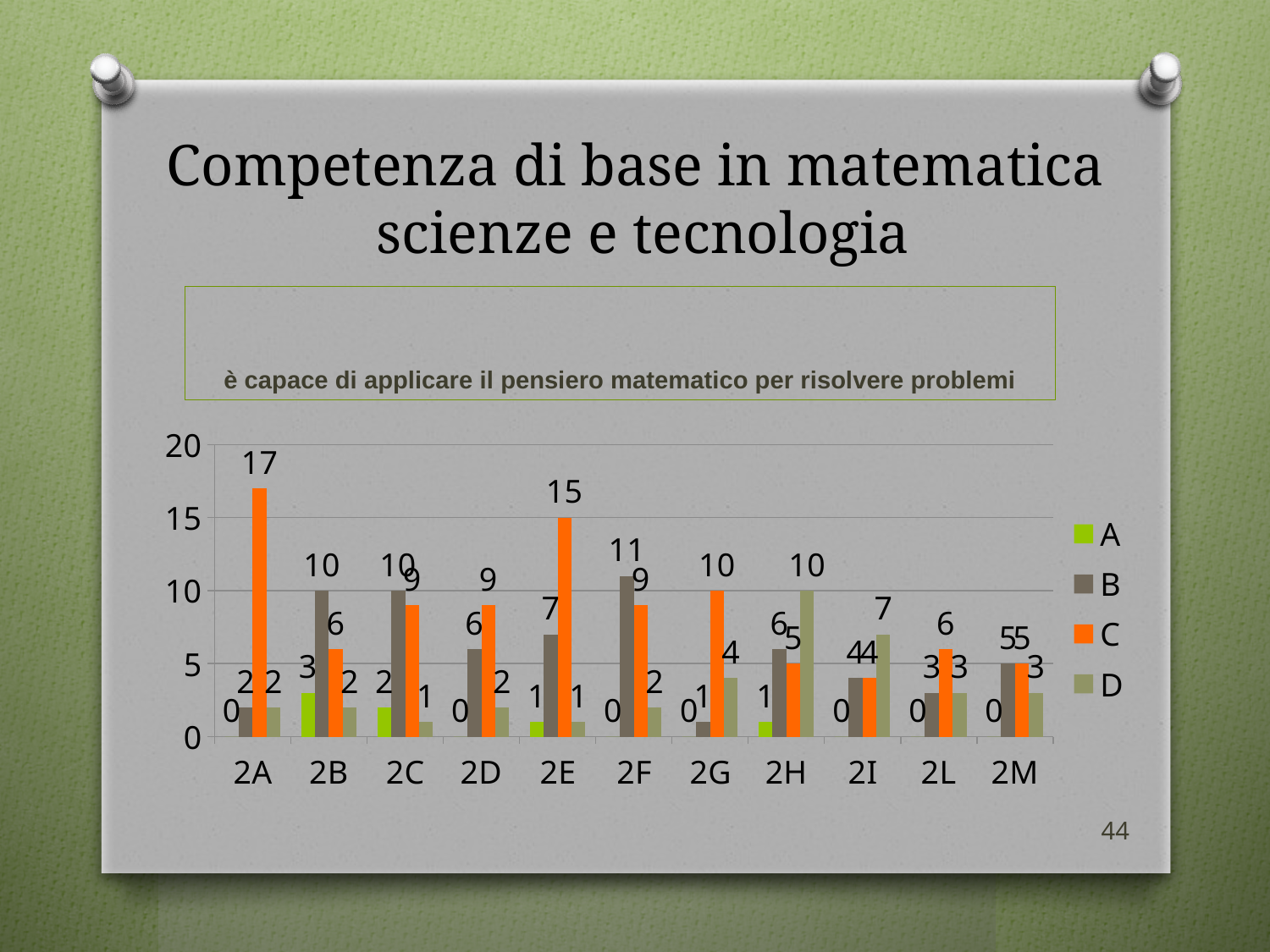
Which class has the highest value for series C? 2A What is the difference between the series C values for 2A and 2E? 2 What is the value of series B for class 2F? 11 Which class has the highest value for series D? 2H What kind of chart is shown on the slide? bar chart What is the value of series C for class 2A? 17 How many series does the legend list? 4 How many classes are shown on the x axis? 11 Which is larger: the series B value for 2F or for 2B? 2F Is the value of series C for class 2E greater or less than 10? greater What is the value of series A for class 2B? 3 What is the value of series D for class 2H? 10